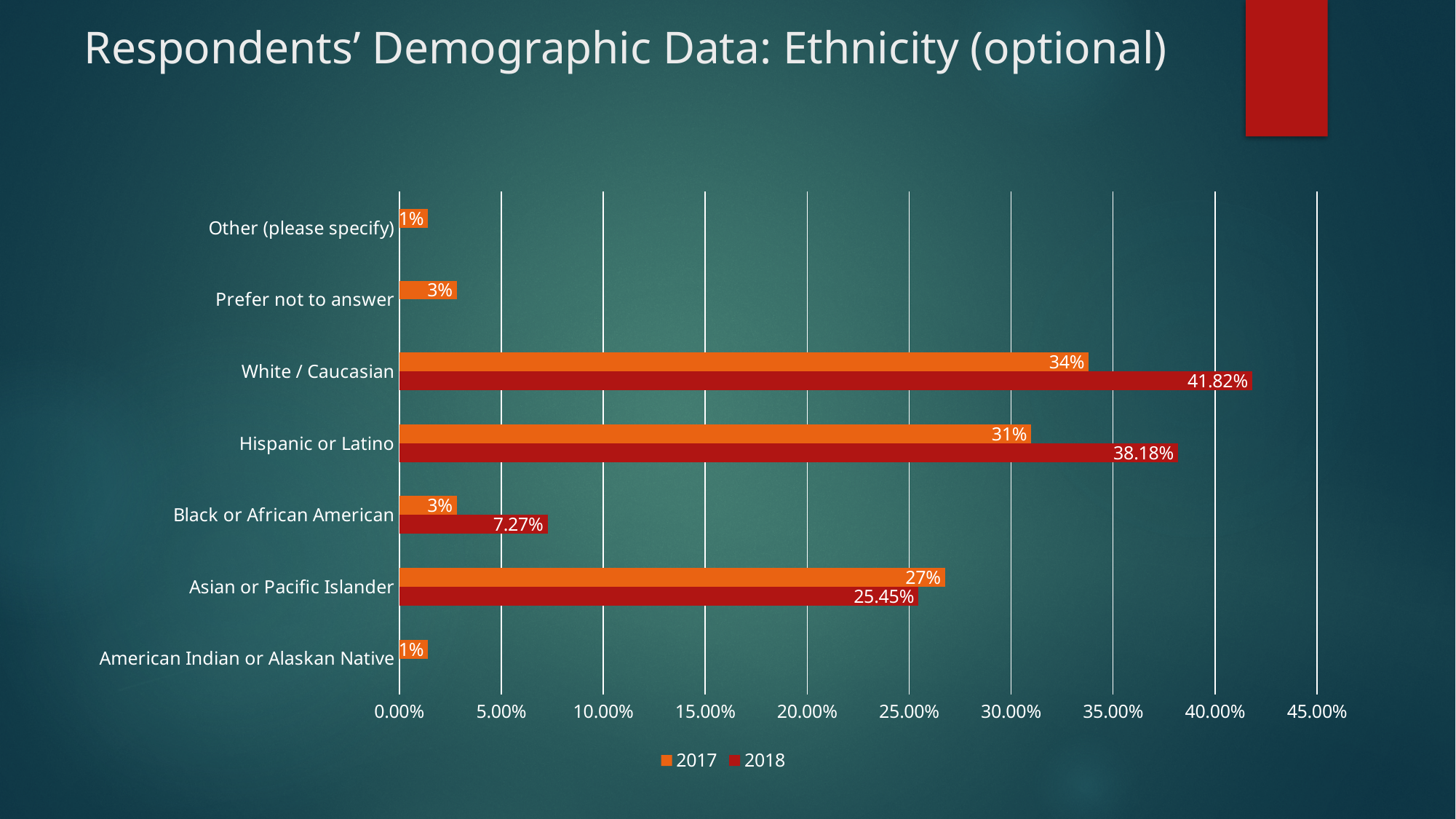
How many series does the legend list? 2 Which category has the highest 2018 value? White / Caucasian By how many percentage points does the 2018 value for White / Caucasian exceed its 2017 value? 7.82 percentage points What is the 2017 value for Asian or Pacific Islander? 27% What is the 2018 value for Black or African American? 7.27% What is the 2018 value for White / Caucasian? 41.82% How many ethnicity categories are shown on the chart? 7 What is the 2017 value for Hispanic or Latino? 31% For Asian or Pacific Islander, which year has the larger value, 2017 or 2018? 2017 Which series is shown in orange in the legend? 2017 What kind of chart is shown on the slide? Bar chart Which category has the lowest 2018 value among those with a 2018 bar? Black or African American